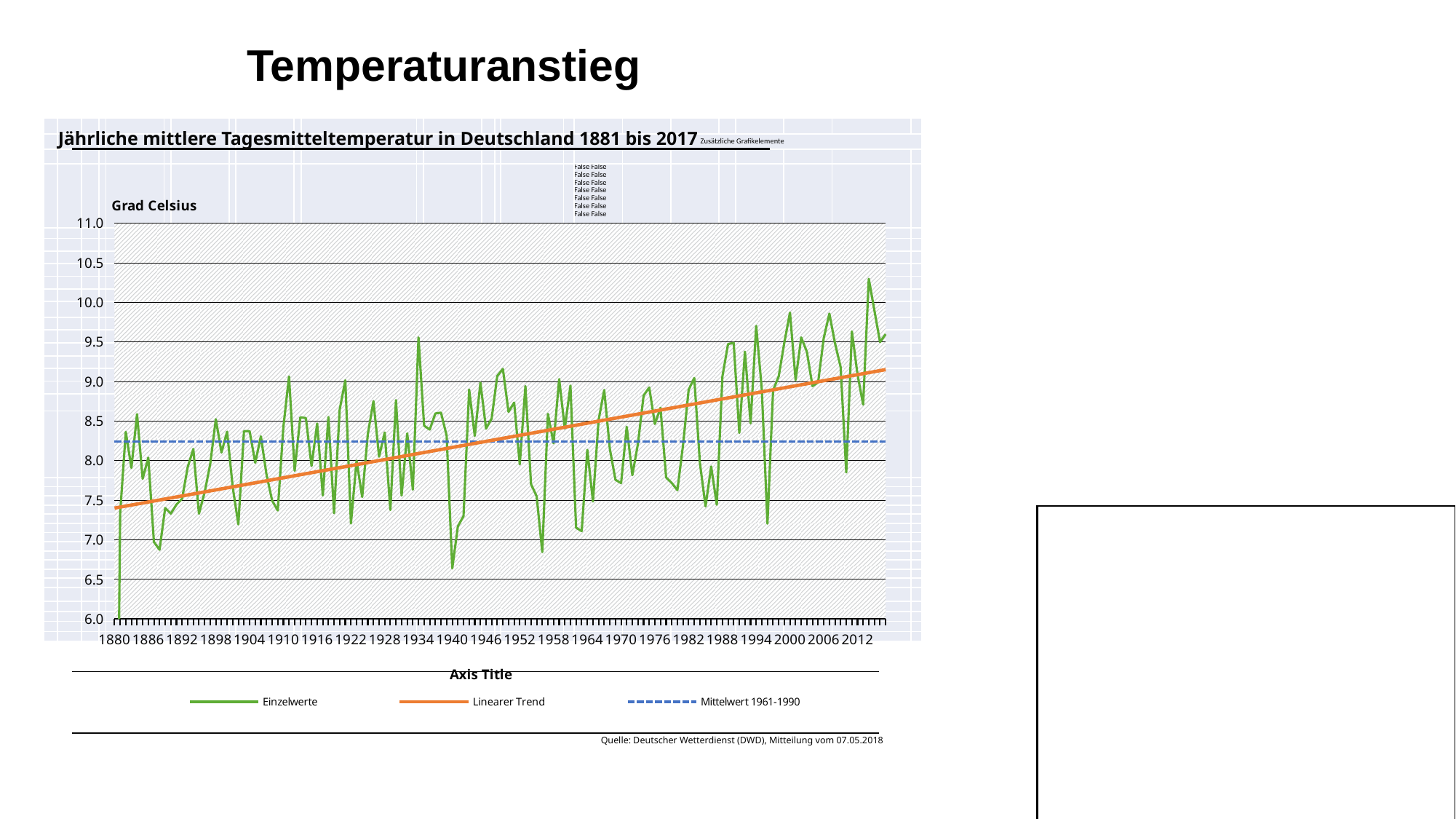
Is the value of the Mittelwert 1961-1990 line greater or less than 8.0? greater What unit is shown as the label of the vertical axis? Grad Celsius How many series does the legend list? 3 What is the title of the chart? Jährliche mittlere Tagesmitteltemperatur in Deutschland 1881 bis 2017 Is the value of the Mittelwert 1961-1990 line greater or less than 8.5? less Which is larger at 2012: the Linearer Trend value or the Mittelwert 1961-1990 value? Linearer Trend Is the Linearer Trend value at 1880 greater or less than 8.0? less How many year labels are printed on the horizontal axis? 23 Does the Linearer Trend line rise or fall from 1880 to 2012? rise What kind of chart is shown on the slide? line chart